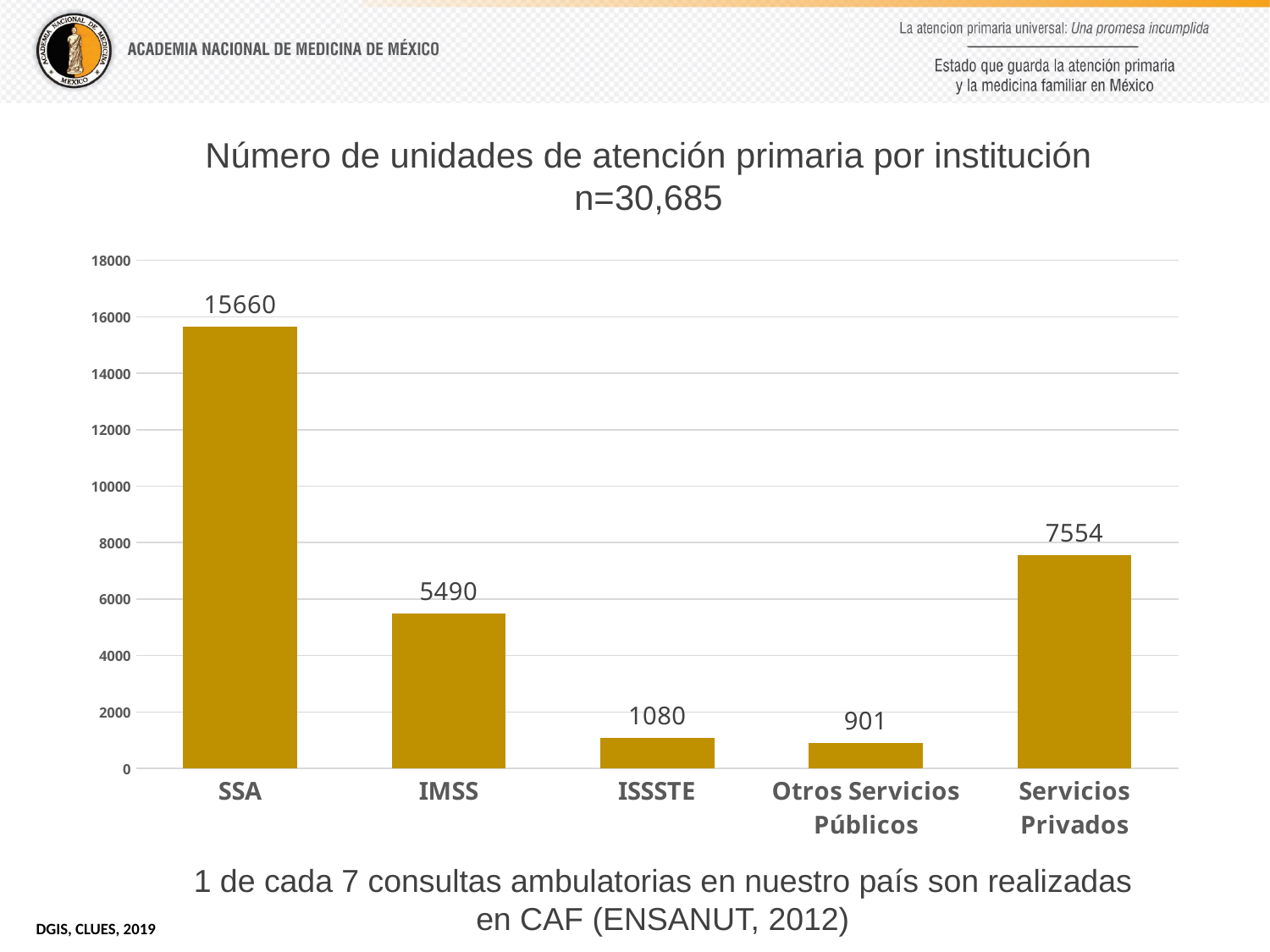
Which institution has the lowest number of primary care units? Otros Servicios Públicos What is the difference between the values for ISSSTE and Otros Servicios Públicos? 179 What kind of chart is shown on the slide? Bar chart What is the value shown for Servicios Privados? 7554 Is the value for IMSS greater or less than 6000? less How many institutions are shown on the x axis? 5 What is the number of primary care units for SSA? 15660 What is the value shown for Otros Servicios Públicos? 901 Which is larger, the value for IMSS or the value for Servicios Privados? Servicios Privados What is the value shown for IMSS? 5490 Which institution has the highest number of primary care units? SSA What is the difference between the values for SSA and Servicios Privados? 8106